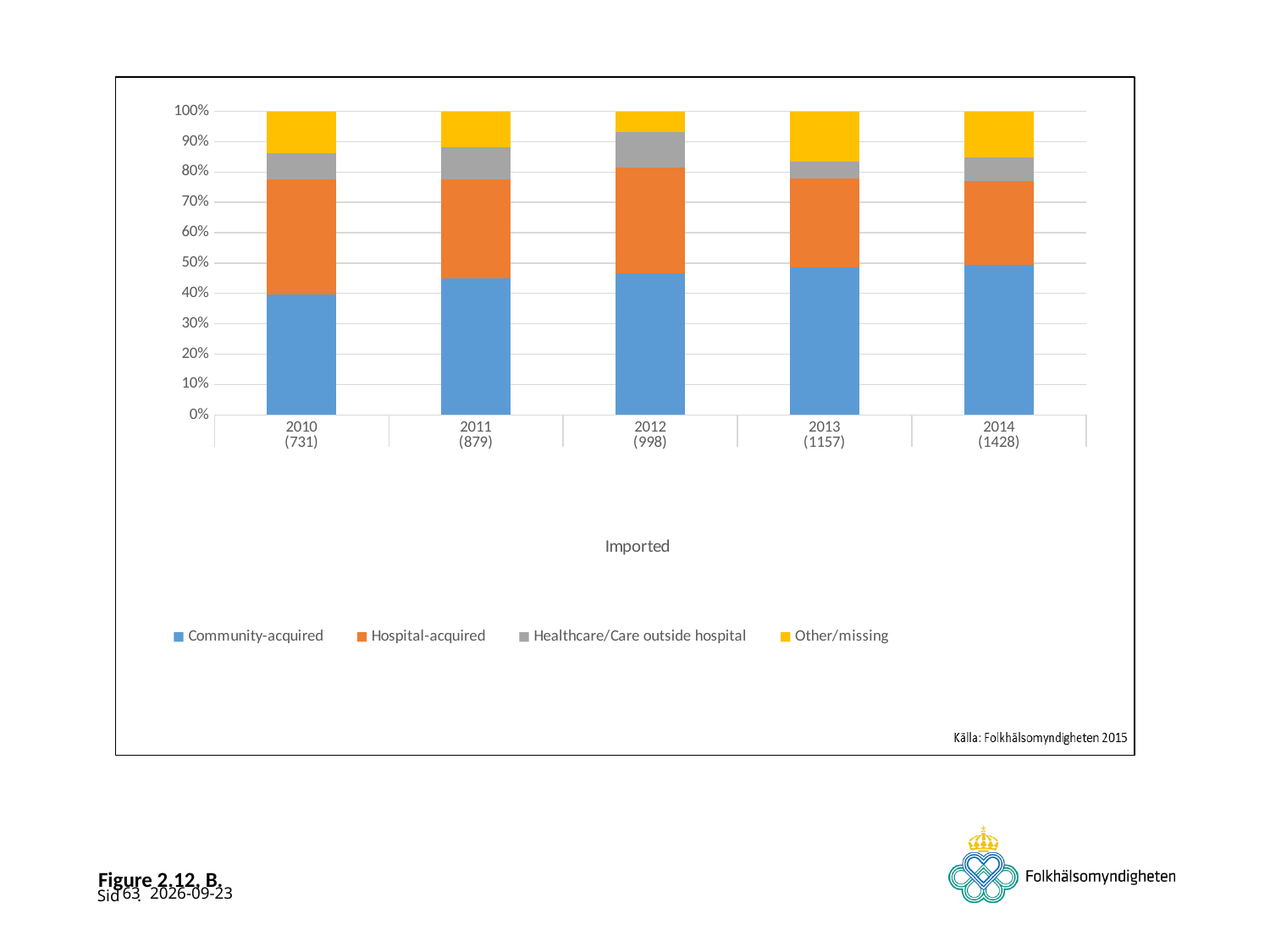
What kind of chart is shown on the slide? Stacked bar chart Is the Community-acquired share in 2010 greater or less than 50%? less In which year is the Other/missing share the smallest? 2012 Does the Community-acquired share rise or fall from 2010 to 2014? rise Which series is shown in yellow in the legend? Other/missing Is the Community-acquired share in 2012 greater or less than 40%? greater What label is shown beneath the x axis of the chart? Imported What number is shown in parentheses under the 2010 category label? 731 How many series does the legend list? 4 In which year is the Community-acquired share the lowest? 2010 What number is shown in parentheses under the 2014 category label? 1428 How many years (categories) are shown on the x axis? 5